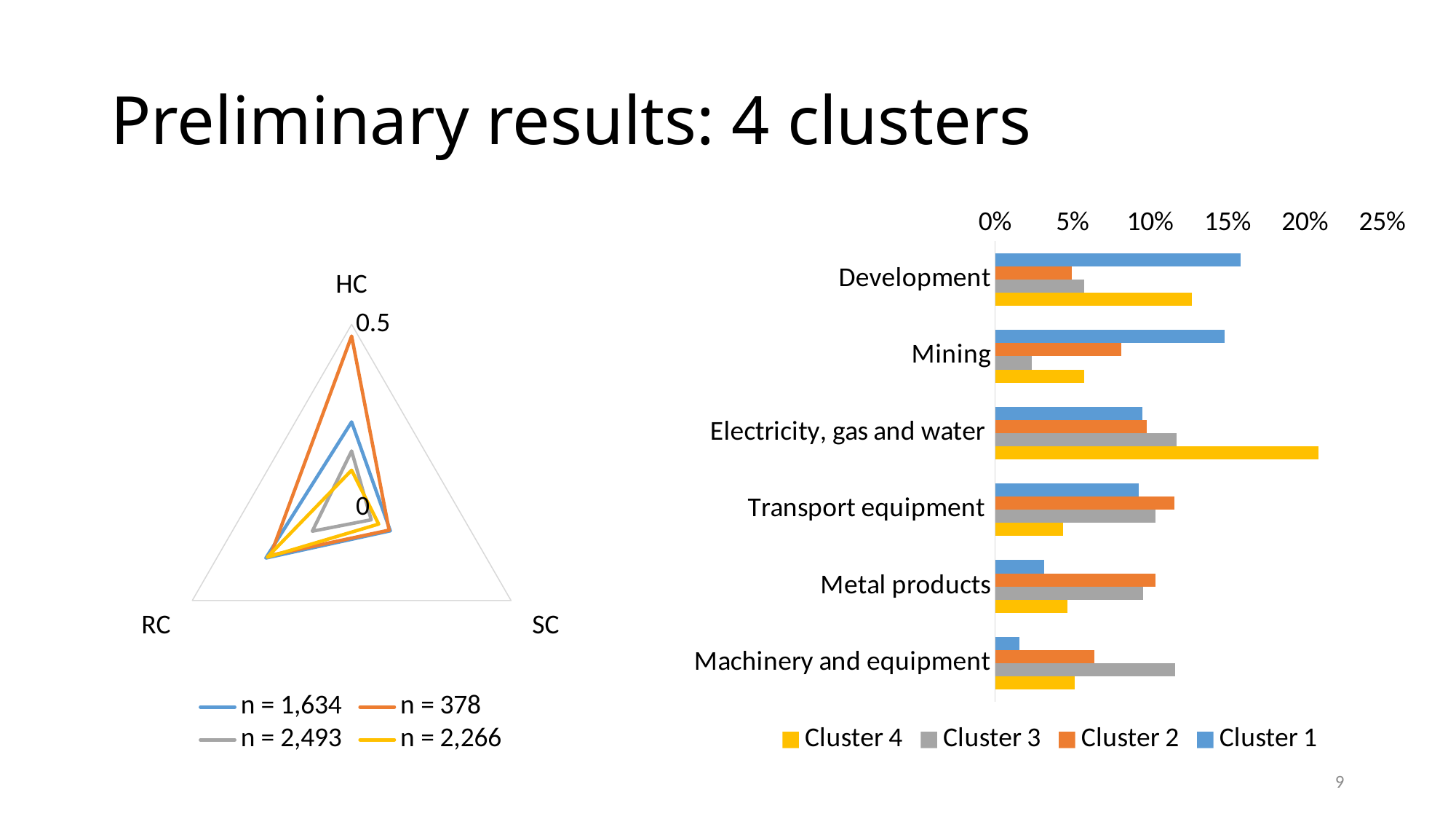
What kind of chart is the chart on the right side of the slide? bar chart What kind of chart is the chart on the left side of the slide? radar chart In the radar chart on the left, which series reaches the highest value on the HC axis? n = 378 In the bar chart on the right, which cluster has the shortest bar for Machinery and equipment? Cluster 1 In the bar chart on the right, how many categories are shown on the vertical axis? 6 In the bar chart on the right, how many series does the legend list? 4 In the bar chart on the right, which category has the longest Cluster 4 bar? Electricity, gas and water In the bar chart on the right, is the value for Cluster 1 in Development greater or less than 15%? greater In the bar chart on the right, is the value for Cluster 1 in Machinery and equipment greater or less than 5%? less In the bar chart on the right, for Mining, which is larger: Cluster 1 or Cluster 3? Cluster 1 In the radar chart on the left, how many series does the legend list? 4 In the bar chart on the right, is the value for Cluster 4 in Electricity, gas and water greater or less than 20%? greater